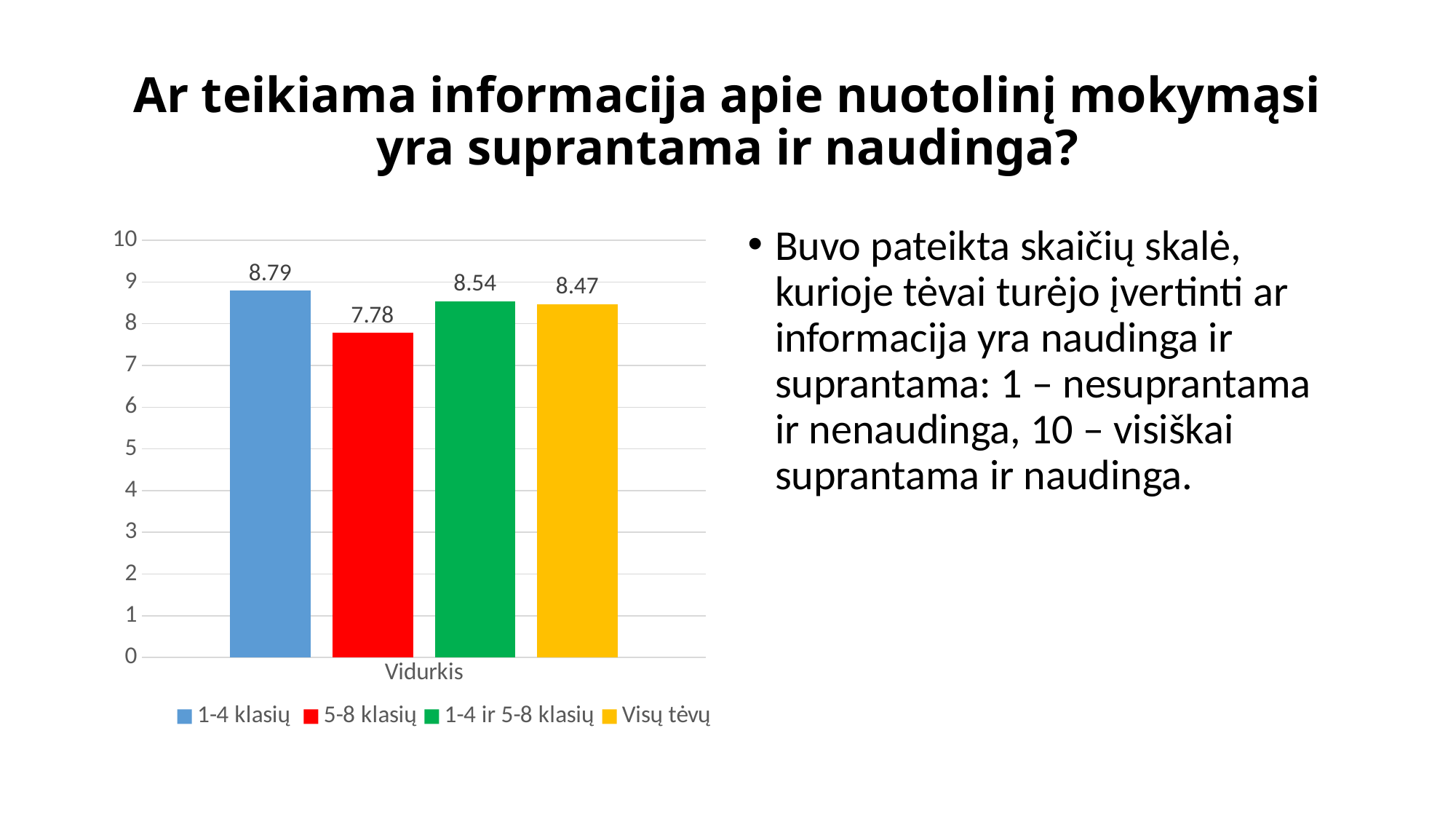
What is the value for 1-4 klasių? 8.79 What is the value for Visų tėvų? 8.47 What is the label on the x axis under the bars? Vidurkis What is the value for 1-4 ir 5-8 klasių? 8.54 What kind of chart is shown on the slide? bar chart Which is larger, the value for 1-4 ir 5-8 klasių or the value for 5-8 klasių? 1-4 ir 5-8 klasių What is the difference between the values for 1-4 klasių and 5-8 klasių? 1.01 Which series has the highest value? 1-4 klasių How many series does the legend list? 4 What is the value for 5-8 klasių? 7.78 Which series has the lowest value? 5-8 klasių Is the value for 5-8 klasių greater or less than 8? less